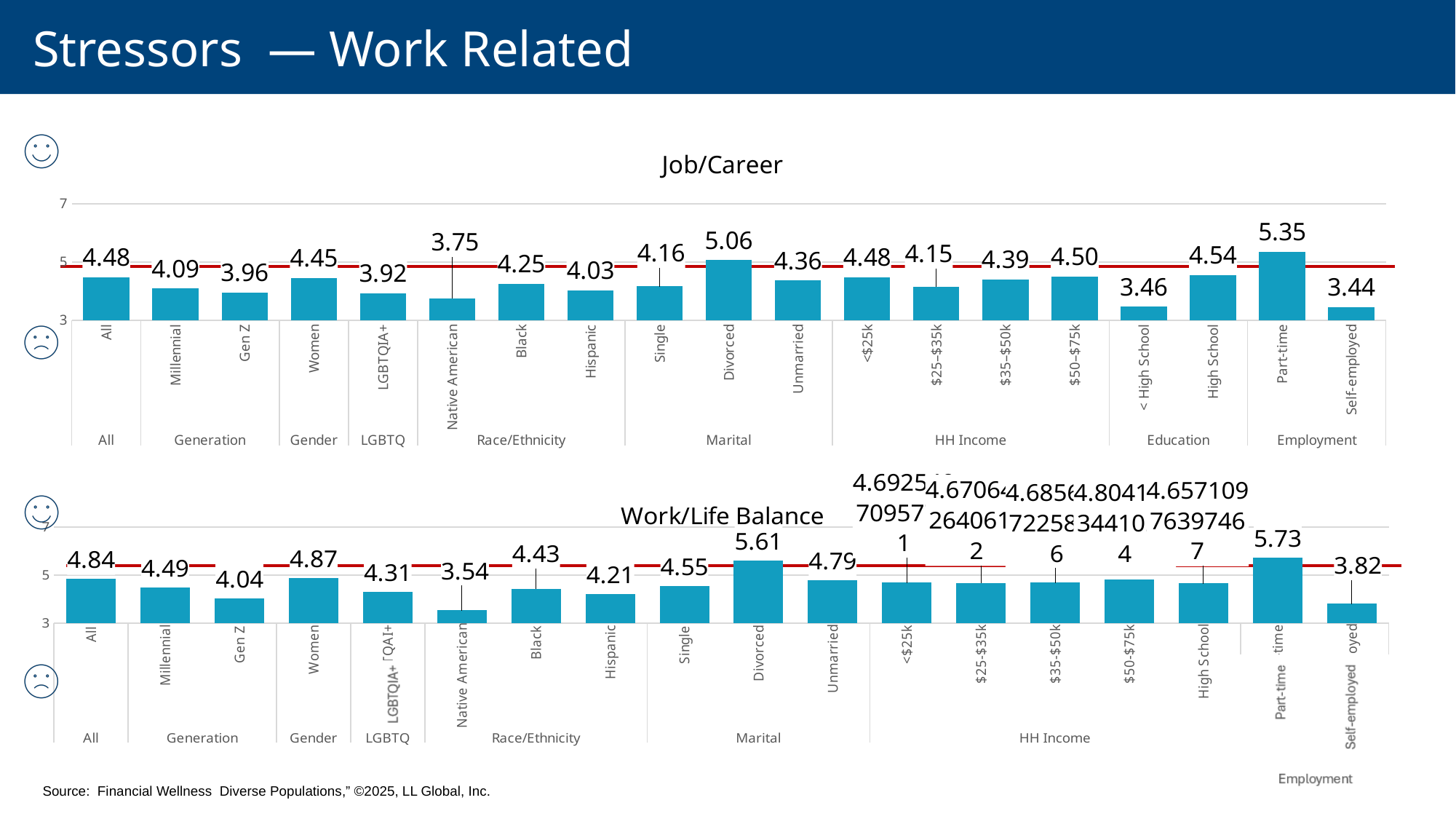
In the Job/Career chart, what is the value for Divorced? 5.06 In the Job/Career chart, which is larger, the value for Women or the value for LGBTQIA+? Women What kind of chart is the Work/Life Balance chart? Bar chart In the Work/Life Balance chart, what is the value for Self-employed? 3.82 In the Work/Life Balance chart, what is the value for Women? 4.87 In the Work/Life Balance chart, what is the difference between the values for Women and Gen Z? 0.83 In the Job/Career chart, what is the value for Native American? 3.75 In the Job/Career chart, which category has the highest value? Part-time In the Job/Career chart, is the value for Part-time greater or less than 5? greater In the Work/Life Balance chart, which category has the lowest value? Native American How many categories are plotted in the Job/Career chart? 19 In the Job/Career chart, what is the difference between the values for Divorced and Single? 0.90